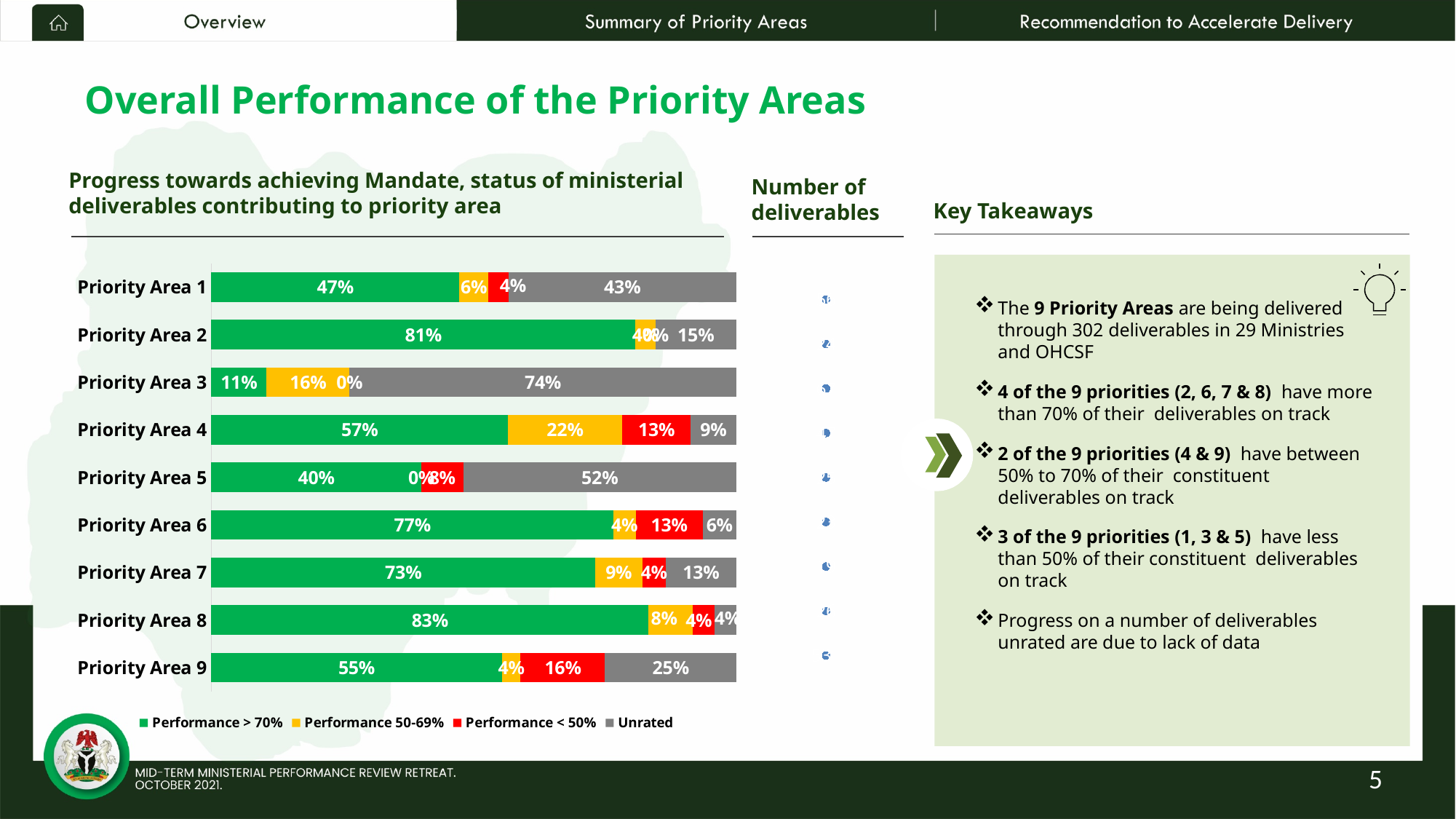
What kind of chart is used to show the status of ministerial deliverables? Stacked bar chart How many series does the chart legend list? 4 What is the Performance < 50% value for Priority Area 9? 16% What is the Unrated value for Priority Area 3? 74% What is the difference between the Unrated values of Priority Area 5 and Priority Area 1? 9 percentage points What is the Performance 50-69% value for Priority Area 4? 22% What is the Performance > 70% value for Priority Area 1? 47% How many priority areas are shown in the chart? 9 Which has a larger Performance > 70% value, Priority Area 6 or Priority Area 7? Priority Area 6 What is the difference between the Performance > 70% values of Priority Area 8 and Priority Area 2? 2 percentage points Which priority area has the highest Performance > 70% value? Priority Area 8 Which priority area has the lowest Performance > 70% value? Priority Area 3